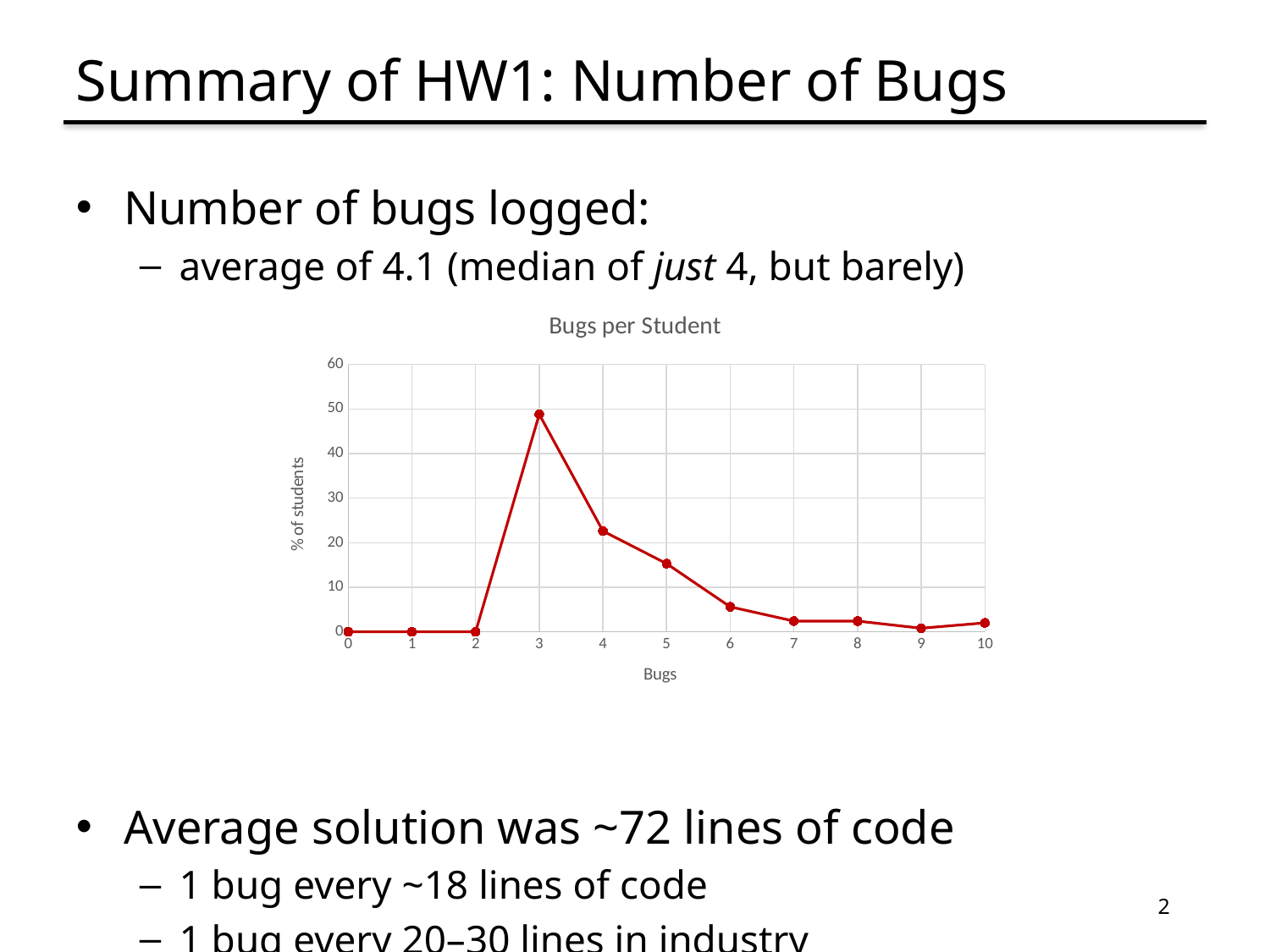
What is the title of the chart? Bugs per Student What is the label of the y axis of the chart? % of students Do the values rise or fall from 3 bugs to 6 bugs? fall Is the value for 6 bugs greater or less than 10? less At which number of bugs is the percentage of students highest? 3 Is the value for 3 bugs greater or less than 40? greater What kind of chart is shown on the slide? line chart Is the value for 4 bugs greater or less than 20? greater What is the value for 2 bugs? 0 What is the value for 0 bugs? 0 How many data points are plotted on the line? 11 Which has a higher percentage of students, 4 bugs or 5 bugs? 4 bugs